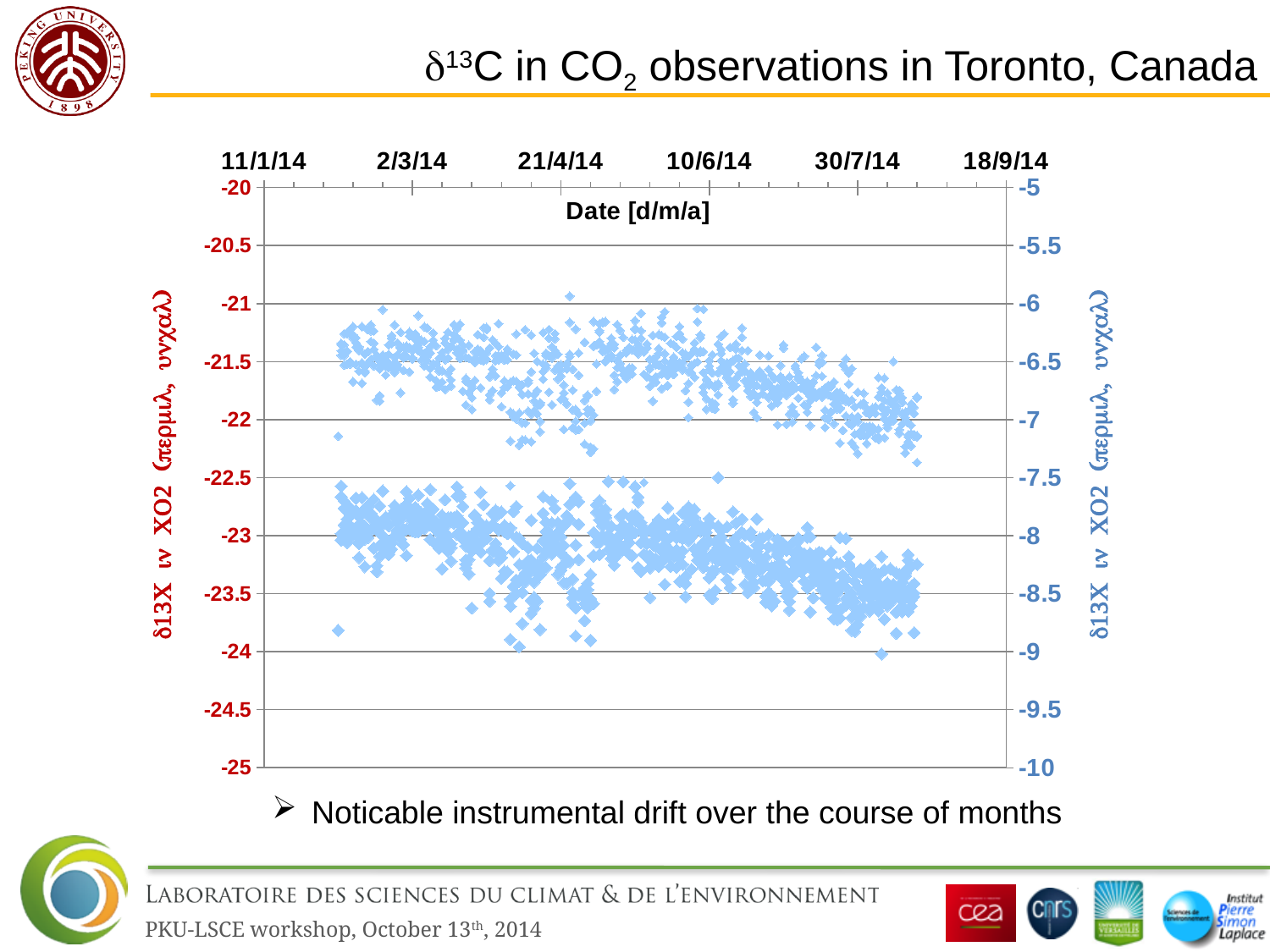
What is the highest value shown on the right vertical axis? -5 On the left axis, are the points in the upper band around 2/3/14 greater or less than -22? greater What is the lowest value shown on the left vertical axis? -25 What is the title of the slide's chart? δ13C in CO2 observations in Toronto, Canada How many date labels are shown along the x axis? 6 What is the last date label on the x axis? 18/9/14 What is the label of the x axis? Date [d/m/a] On the left axis, are the points in the lower band around 30/7/14 greater or less than -22.5? less What kind of chart is shown on the slide? scatter chart Do the plotted values rise or fall from left to right along the x axis? fall What is the first date label on the x axis? 11/1/14